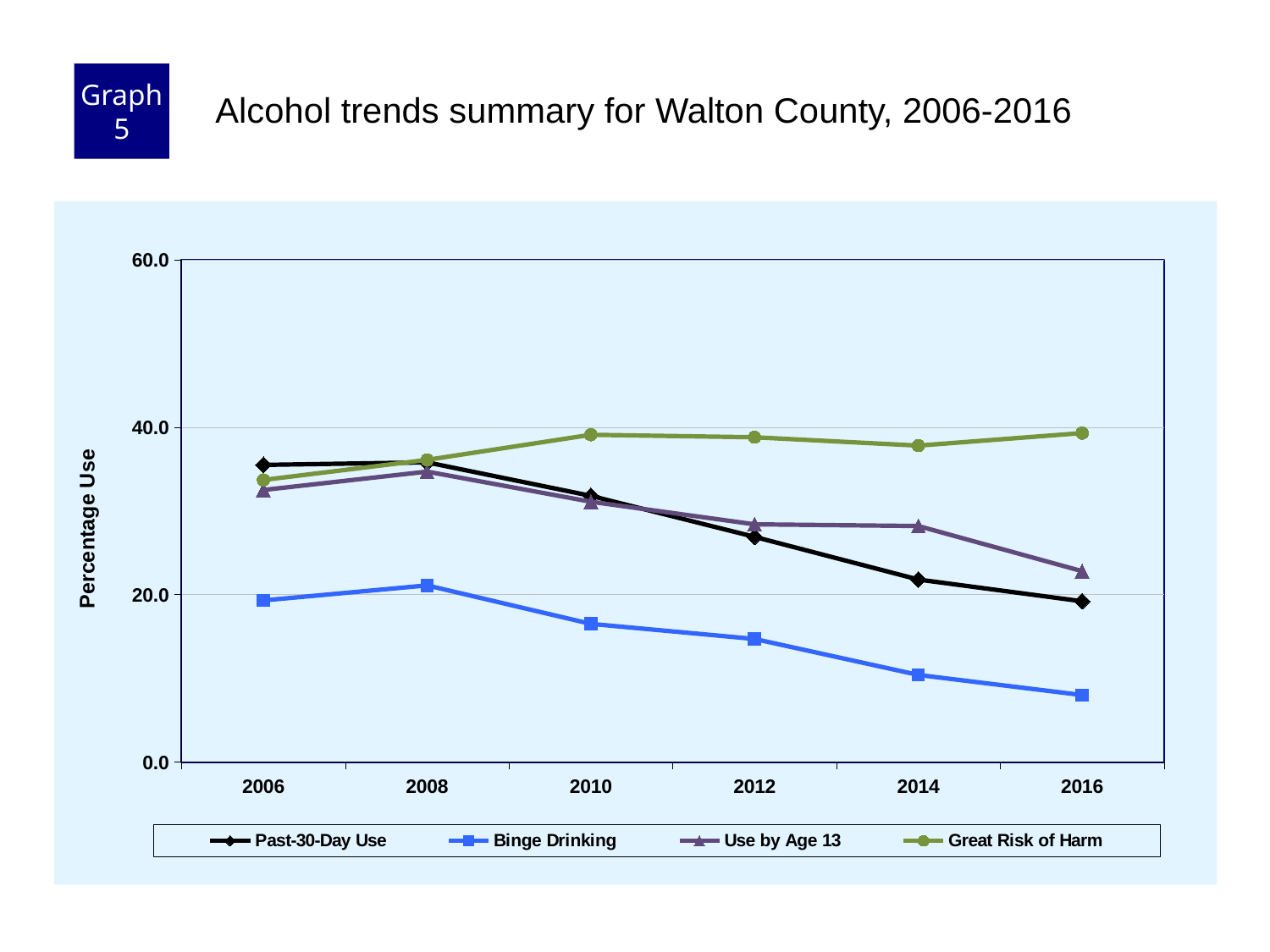
Is the value for Use by Age 13 in 2016 greater or less than 20.0? greater Which series has the lowest value in 2016? Binge Drinking Does the Past-30-Day Use line rise or fall from 2008 to 2016? Fall Which series has the highest value in 2016? Great Risk of Harm What is the label on the y axis? Percentage Use How many series does the legend list? 4 What kind of chart is shown on the slide? Line chart In 2014, which is larger: Use by Age 13 or Past-30-Day Use? Use by Age 13 Is the value for Past-30-Day Use in 2006 greater or less than 40.0? less Does the Binge Drinking line rise or fall from 2008 to 2016? Fall How many years are plotted along the x axis? 6 Is the value for Binge Drinking in 2016 greater or less than 20.0? less